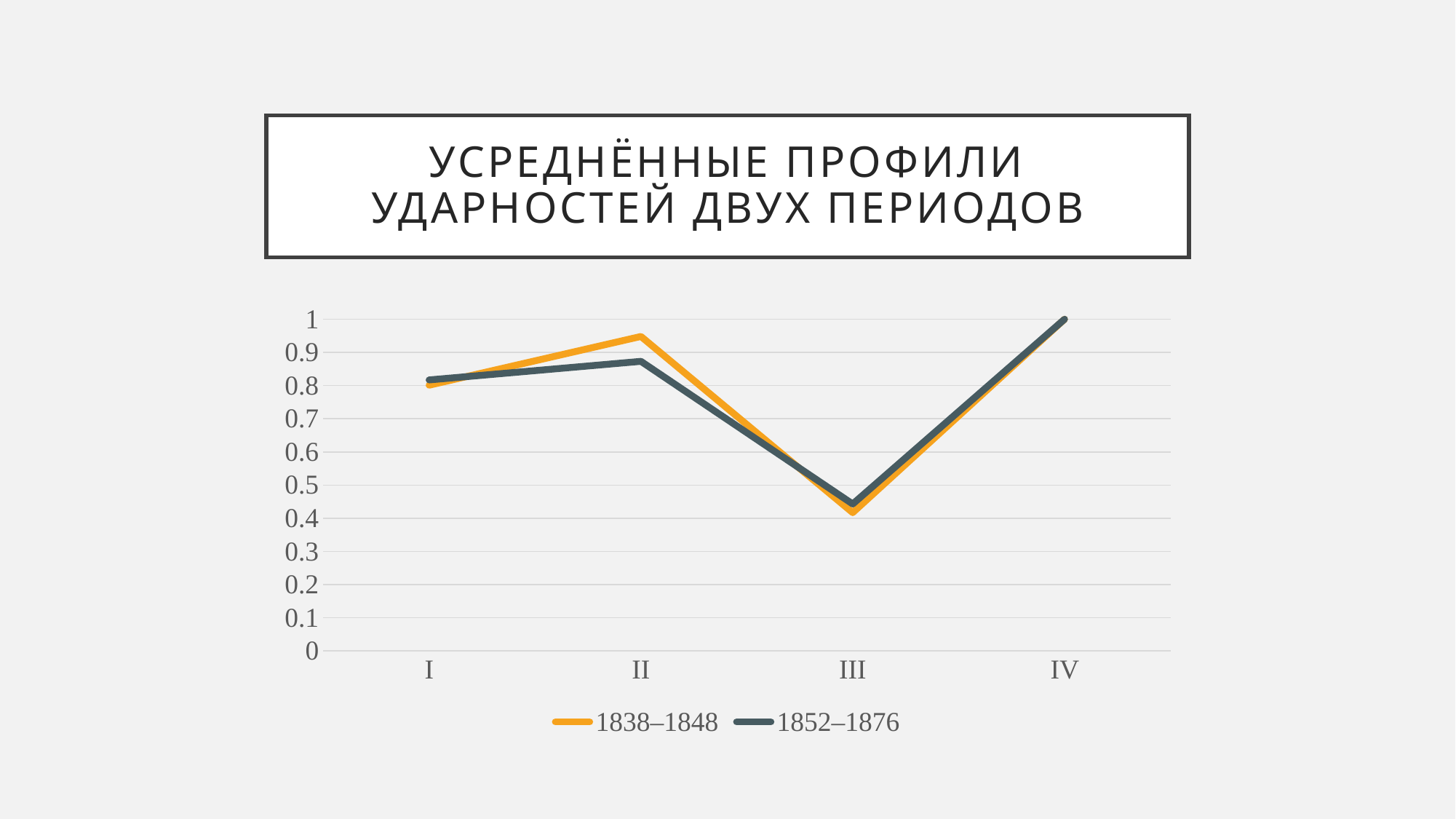
How many series does the legend list? 2 At which category does the 1838–1848 series reach its highest value? IV At category II, which series has the higher value, 1838–1848 or 1852–1876? 1838–1848 Which colour is used for the 1838–1848 series? orange How many categories are shown on the x axis? 4 At which category does the 1838–1848 series reach its lowest value? III Do the values of the 1852–1876 series rise or fall from category II to category III? fall Is the value of the 1838–1848 series at category III greater or less than 0.5? less What is the value of the 1852–1876 series at category IV? 1 Is the value of the 1838–1848 series at category II greater or less than 0.9? greater What kind of chart is shown on the slide? line chart At which category does the 1852–1876 series reach its lowest value? III